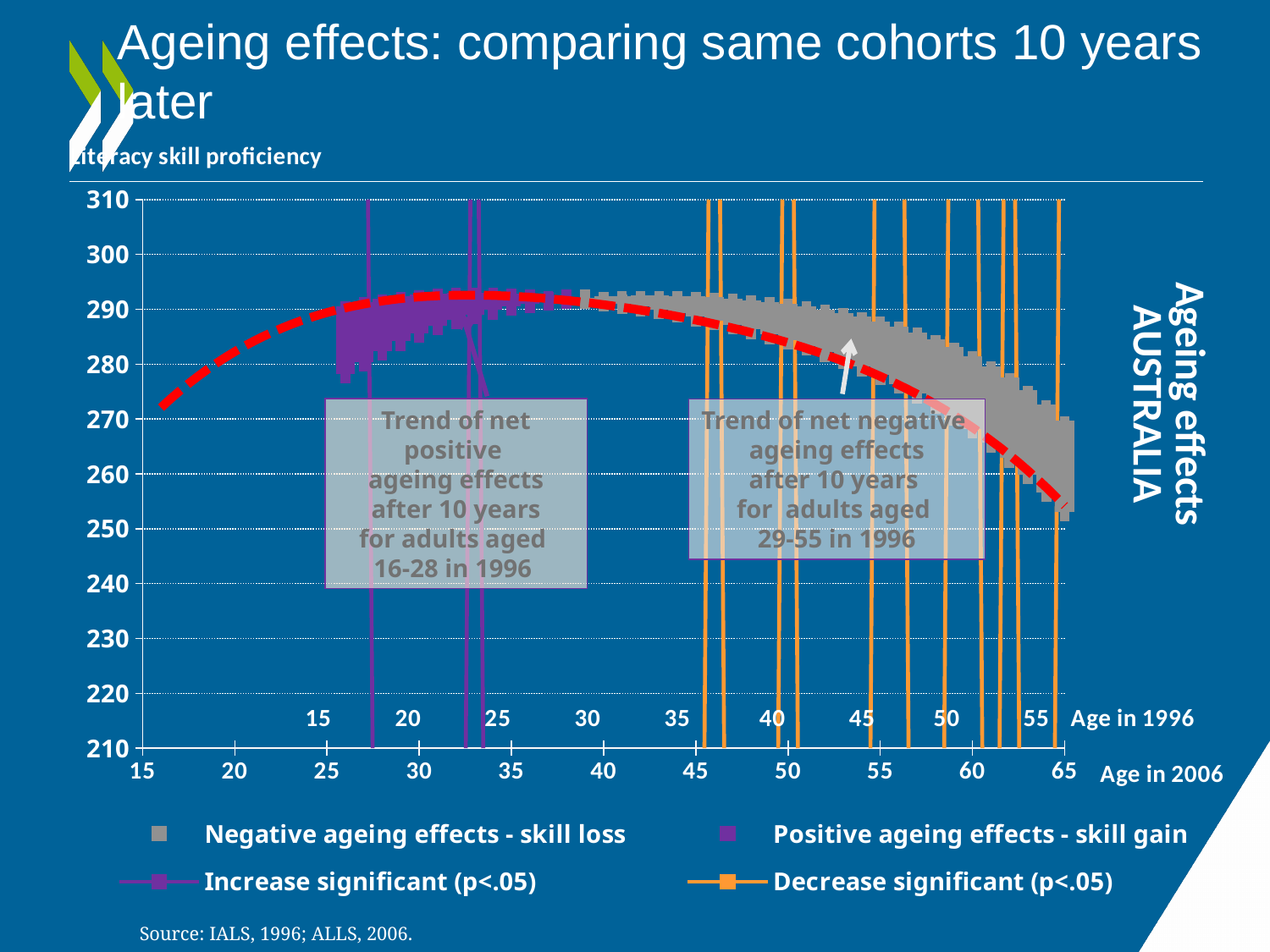
What is the highest value shown on the literacy skill proficiency axis? 310 According to the annotation, adults of which ages in 1996 show a trend of net negative ageing effects after 10 years? 29-55 What is the lowest value shown on the literacy skill proficiency axis? 210 Does the red dashed trend curve rise or fall between age 15 and age 30 in 2006? rise How many entries does the chart's legend list? 4 Does the red dashed trend curve rise or fall between age 45 and age 65 in 2006? fall What is the title of the chart on the slide? Ageing effects: comparing same cohorts 10 years later Which legend entry is shown in grey? Negative ageing effects - skill loss How many tick labels are shown on the 'Age in 2006' axis? 11 Is the red dashed trend curve at age 65 in 2006 greater or less than 260? less Is the peak of the red dashed trend curve greater or less than 300? less According to the annotation, adults of which ages in 1996 show a trend of net positive ageing effects after 10 years? 16-28